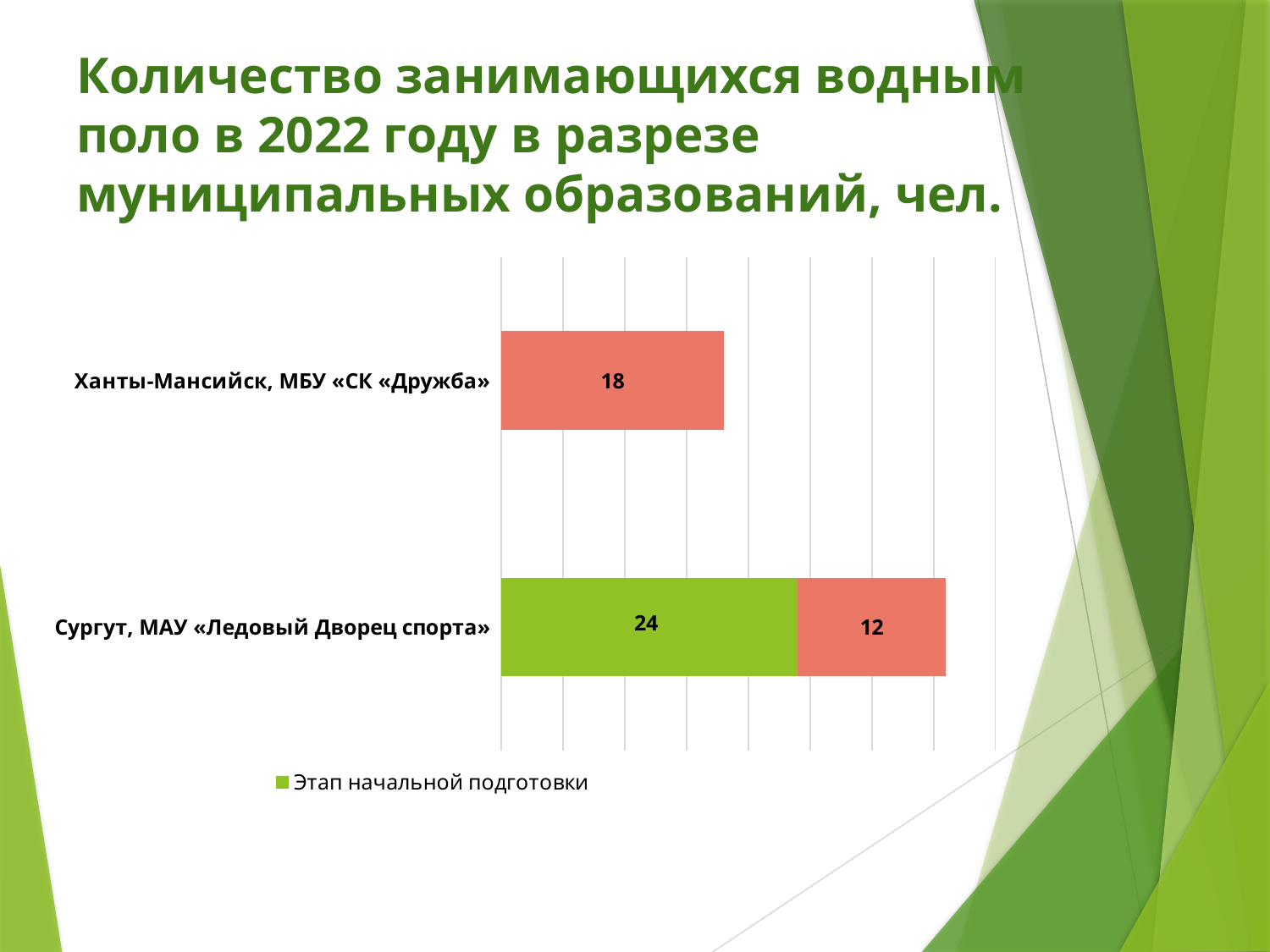
Within the bar for Сургут, МАУ «Ледовый Дворец спорта», how much larger is the green segment (24) than the red segment (12)? 12 How many series does the chart legend list? 1 What is the value of «Этап начальной подготовки» for Сургут, МАУ «Ледовый Дворец спорта»? 24 What value is printed on the red (salmon) segment of the bar for Сургут, МАУ «Ледовый Дворец спорта»? 12 Which organisation has the longer bar overall, Сургут, МАУ «Ледовый Дворец спорта» or Ханты-Мансийск, МБУ «СК «Дружба»? Сургут, МАУ «Ледовый Дворец спорта» What is the difference between the total for Сургут, МАУ «Ледовый Дворец спорта» (24 + 12) and the value for Ханты-Мансийск, МБУ «СК «Дружба»? 18 What is the name of the series listed in the chart legend? Этап начальной подготовки What kind of chart is shown on the slide? Bar chart Which category has the highest total value in the chart? Сургут, МАУ «Ледовый Дворец спорта» How many municipal organisations (categories) are shown in the chart? 2 What value is printed on the bar for Ханты-Мансийск, МБУ «СК «Дружба»? 18 What is the total of the stacked bar for Сургут, МАУ «Ледовый Дворец спорта»? 36